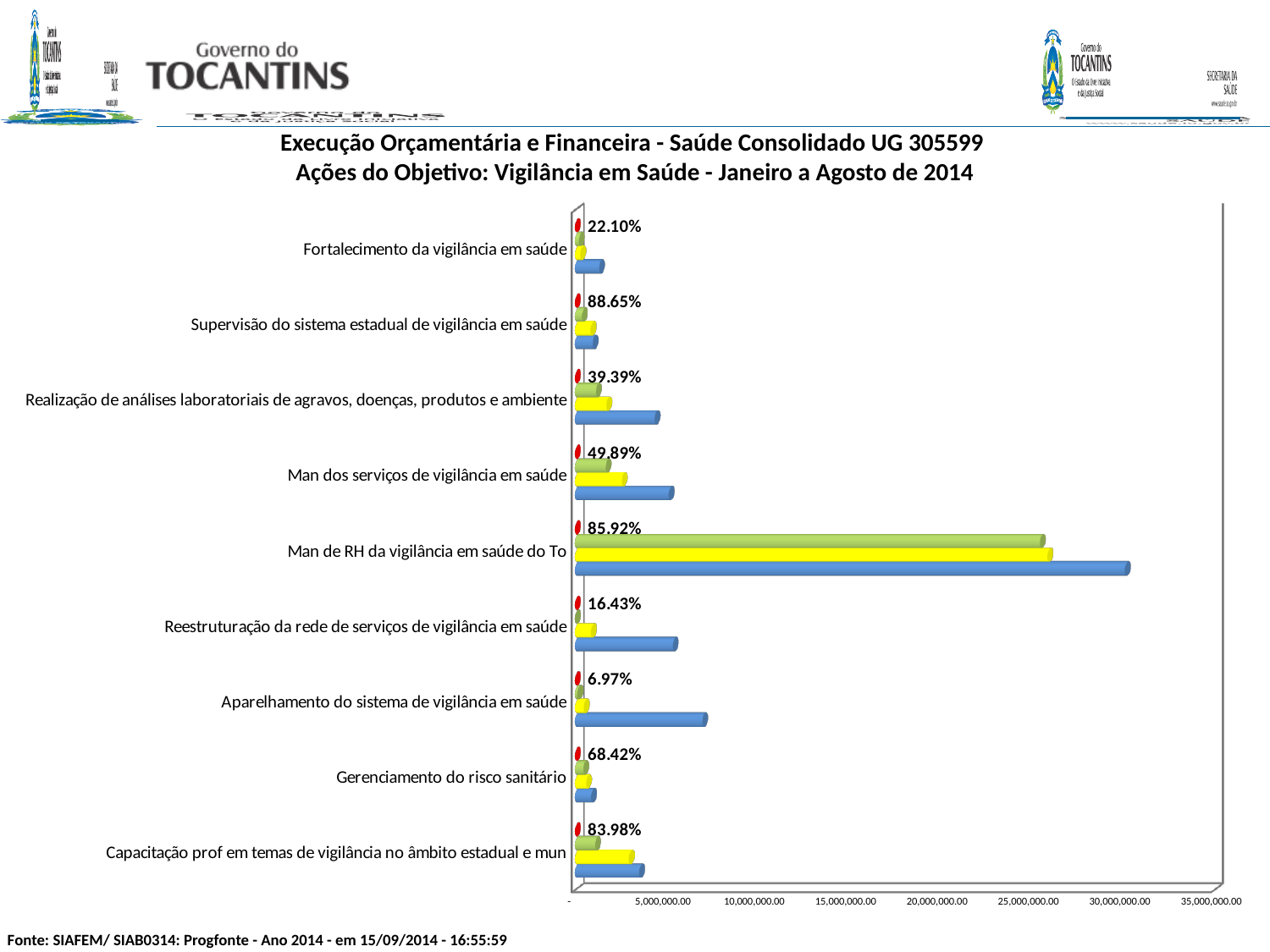
Which action has the lowest percentage label? Aparelhamento do sistema de vigilância em saúde What is the difference between the highest percentage (88.65%) and the lowest percentage (6.97%)? 81.68% How many actions (categories) are plotted on the chart? 9 What percentage is shown for 'Man de RH da vigilância em saúde do To'? 85.92% What percentage is shown for 'Supervisão do sistema estadual de vigilância em saúde'? 88.65% What percentage is shown for 'Aparelhamento do sistema de vigilância em saúde'? 6.97% Which action has the longest blue bar? Man de RH da vigilância em saúde do To Is the blue bar for 'Fortalecimento da vigilância em saúde' greater or less than 5,000,000.00? less Which has a higher percentage: 'Gerenciamento do risco sanitário' or 'Man dos serviços de vigilância em saúde'? Gerenciamento do risco sanitário Which action has the highest percentage label? Supervisão do sistema estadual de vigilância em saúde What kind of chart is shown on the slide? Bar chart